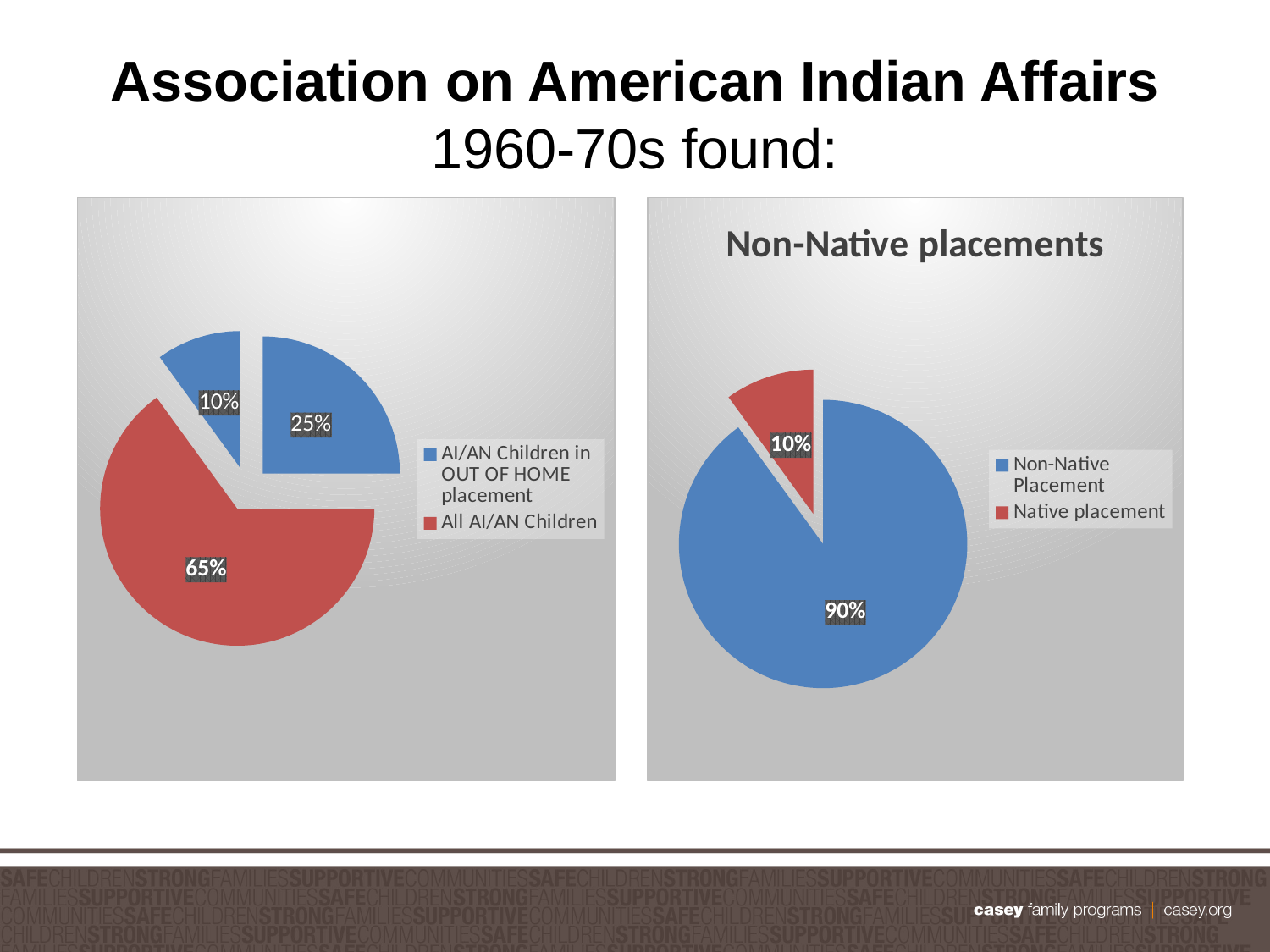
In the 'Non-Native placements' chart, what colour is the Native placement slice? red In the chart on the left, which legend entry corresponds to the largest slice? All AI/AN Children In the 'Non-Native placements' chart, which slice is the smallest? Native placement In the 'Non-Native placements' chart, what is the difference between the Non-Native Placement share and the Native placement share? 80% What type of chart is the chart on the left of the slide? pie chart In the 'Non-Native placements' chart, which slice is the largest? Non-Native Placement In the 'Non-Native placements' chart, what share is labelled for Native placement? 10% How many slices does the pie chart on the left have? 3 How many entries does the legend of the 'Non-Native placements' chart list? 2 In the chart on the left, what share is labelled on the red slice for All AI/AN Children? 65% What type of chart is the chart on the right titled 'Non-Native placements'? pie chart In the 'Non-Native placements' chart, what share is labelled for Non-Native Placement? 90%